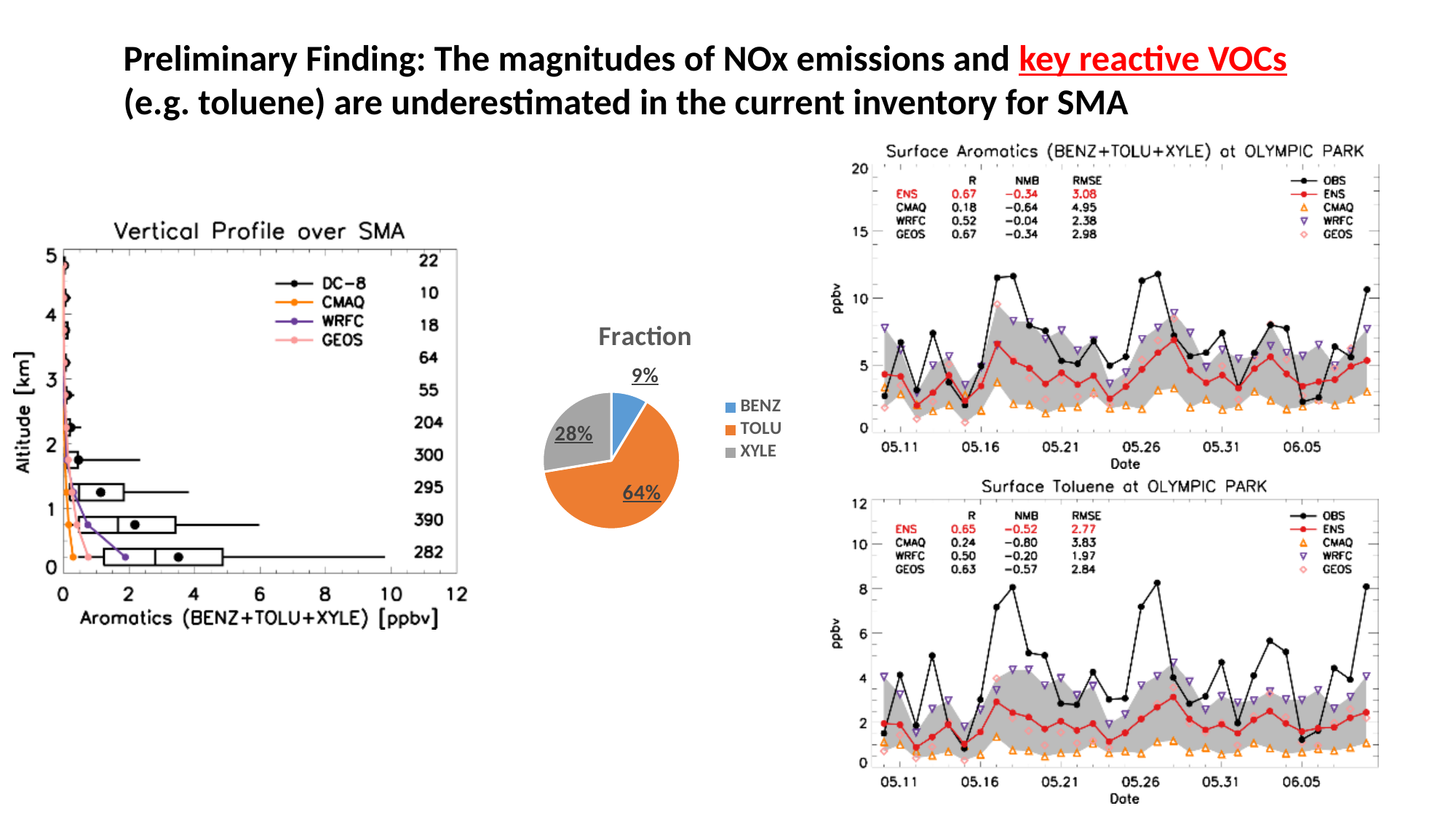
How many slices does the Fraction pie chart have? 3 How many series does the legend of the Surface Aromatics at OLYMPIC PARK chart list? 5 In the Fraction pie chart, which category has the largest slice? TOLU In the Fraction pie chart, what share does XYLE have? 28% How many series does the legend of the Vertical Profile over SMA chart list? 4 In the Fraction pie chart, which category has the smallest slice? BENZ In the Fraction pie chart, what share does TOLU have? 64% In the Surface Toluene at OLYMPIC PARK chart, what R value is printed for ENS? 0.65 In the Surface Aromatics at OLYMPIC PARK chart, what RMSE value is printed for CMAQ? 4.95 In the Fraction pie chart, what share does BENZ have? 9% What kind of chart is the Fraction chart? Pie chart In the Surface Aromatics at OLYMPIC PARK chart, is the OBS peak value near 05.17 greater or less than 10 ppbv? greater